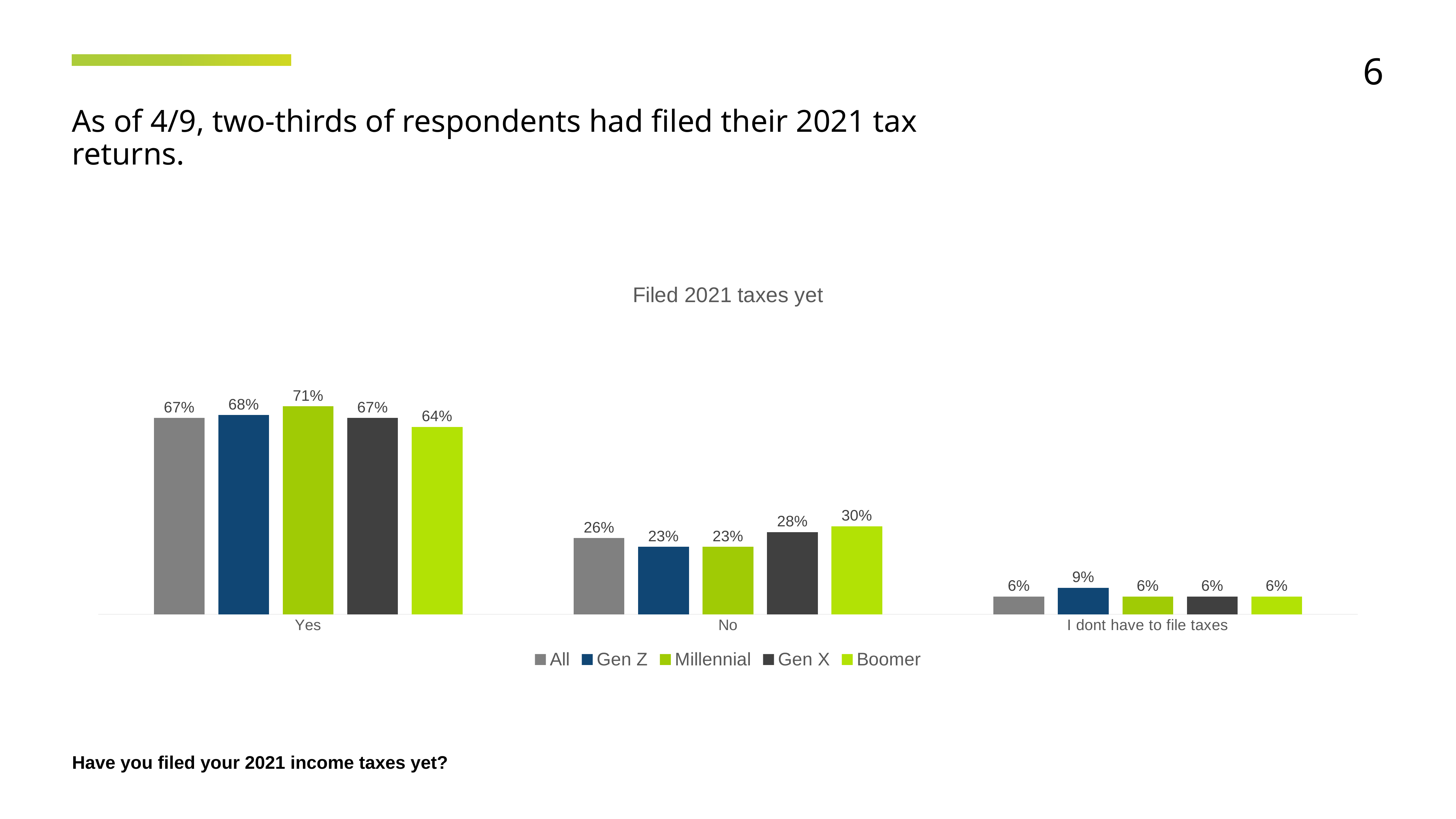
What is the value for Boomer in the No category? 30% In the No category, which is larger: the Boomer value or the Gen Z value? Boomer How many categories are shown on the x axis? 3 How many series does the legend list? 5 What is the title of the chart? Filed 2021 taxes yet What kind of chart is shown on the slide? Bar chart What is the value for Gen Z in the 'I dont have to file taxes' category? 9% Which series has the lowest value in the Yes category? Boomer Which series has the highest value in the Yes category? Millennial What is the value for All in the No category? 26% What is the difference between the Millennial and Boomer values in the Yes category? 7% What is the value for Millennial in the Yes category? 71%